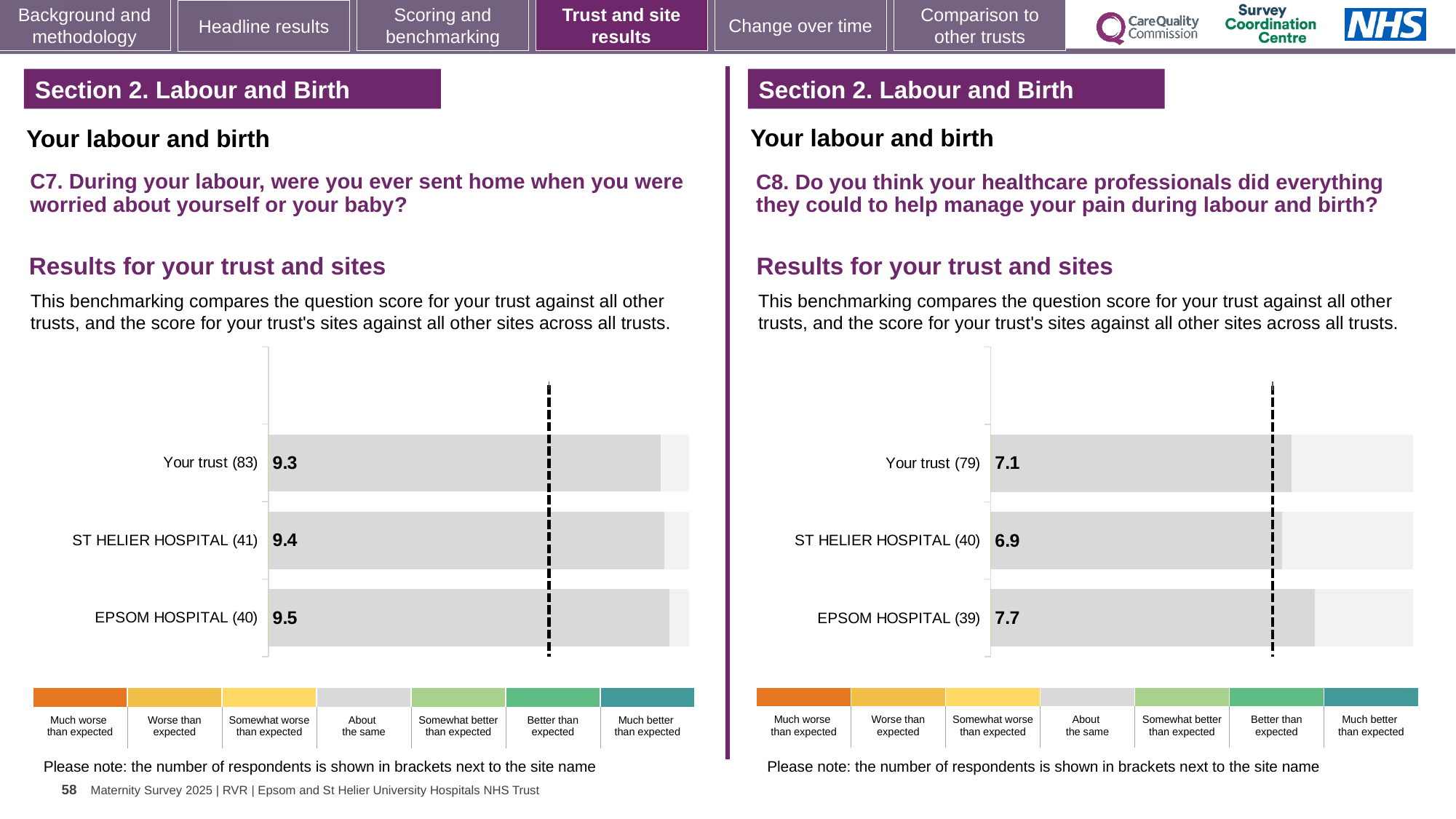
In the right chart (C8), what is the score for Your trust? 7.1 In the left chart (C7), how many bars are plotted? 3 In the left chart (C7), what is the difference between the scores for EPSOM HOSPITAL and Your trust? 0.2 In the right chart (C8), which site or trust has the lowest score? ST HELIER HOSPITAL In the right chart (C8), which has the larger score, EPSOM HOSPITAL or ST HELIER HOSPITAL? EPSOM HOSPITAL In the right chart (C8), what is the difference between the scores for EPSOM HOSPITAL and ST HELIER HOSPITAL? 0.8 What type of chart is used in the left chart (C7)? Bar chart In the left chart (C7), what is the score for EPSOM HOSPITAL? 9.5 In the right chart (C8), how many respondents are shown in brackets for EPSOM HOSPITAL? 39 In the left chart (C7), what is the score for Your trust? 9.3 In the left chart (C7), which site or trust has the highest score? EPSOM HOSPITAL In the right chart (C8), what is the score for ST HELIER HOSPITAL? 6.9